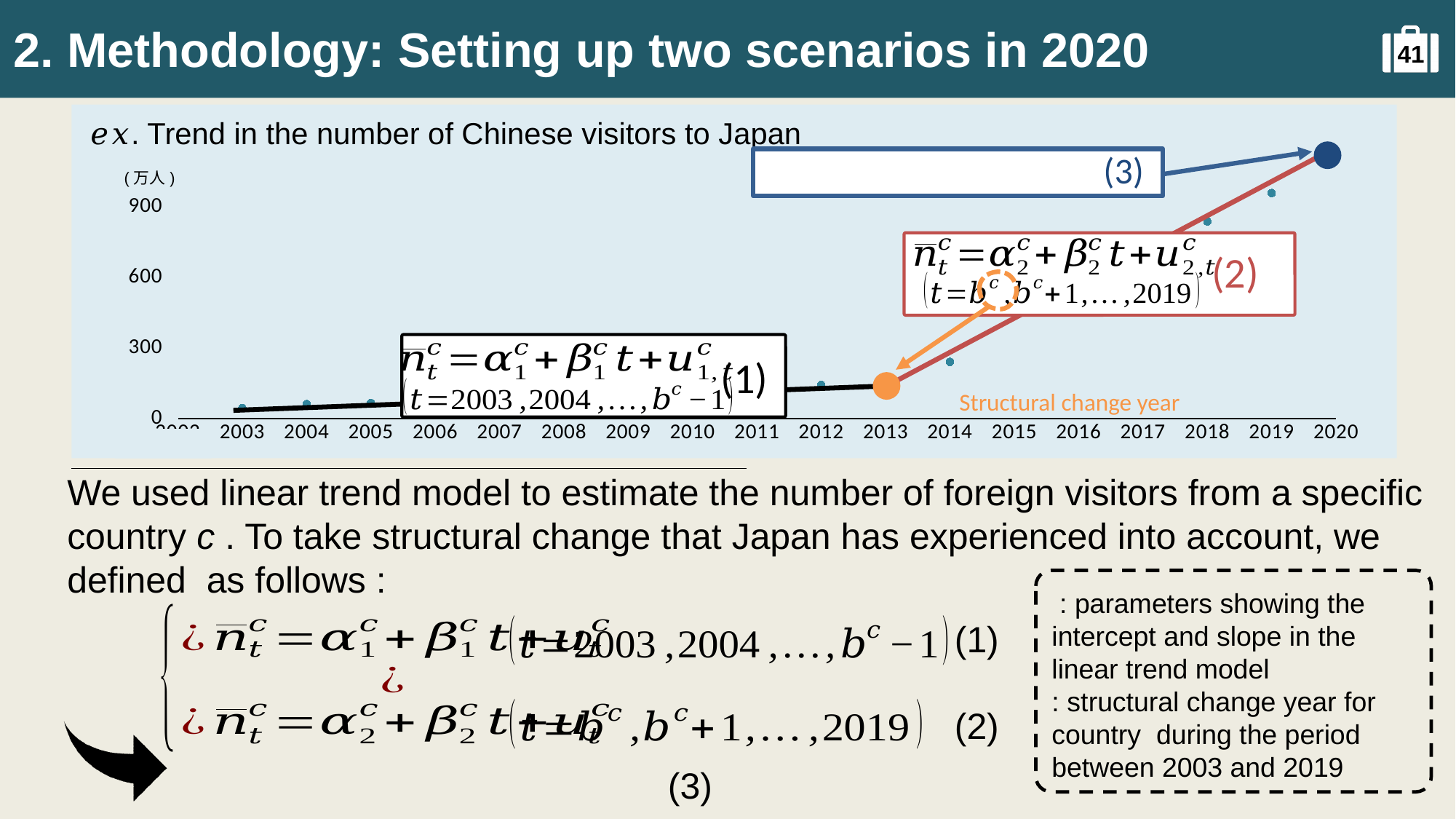
How many years are labelled on the x axis of the chart? 18 What kind of chart is shown on the slide? scatter chart with trend lines Which year is marked as the structural change year on the chart? 2013 Is the value for 2019 greater or less than 900? greater Which year has a larger value, 2018 or 2014? 2018 Which year has the highest value on the chart? 2019 What is the highest tick value shown on the y axis? 900 Is the value for 2014 greater or less than 300? less Is the value for 2018 greater or less than 900? less Do the values on the chart generally rise or fall from 2003 to 2020? rise What is the title of the chart? Trend in the number of Chinese visitors to Japan